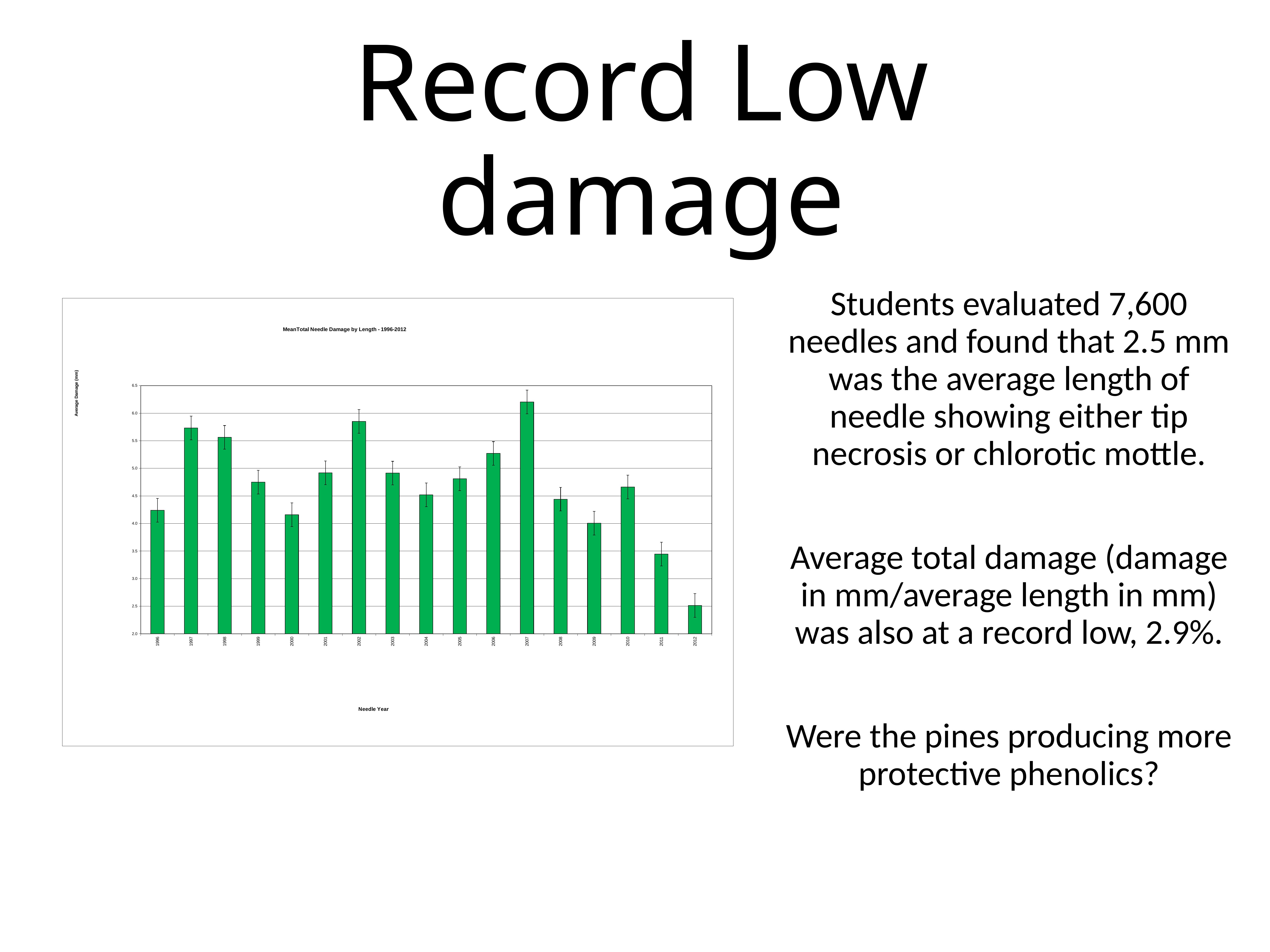
Which needle year has the lowest average damage? 2012 Is the average damage for 2007 greater or less than 6.0? greater What kind of chart is shown on the slide? Bar chart Is the average damage for 2004 greater or less than 5.0? less What is the label on the x axis of the chart? Needle Year Is the average damage for 2011 greater or less than 4.0? less Do the values rise or fall from 2010 to 2012? fall Which needle year has the highest average damage? 2007 Which has the higher average damage, 2011 or 2012? 2011 How many needle years are plotted on the chart? 17